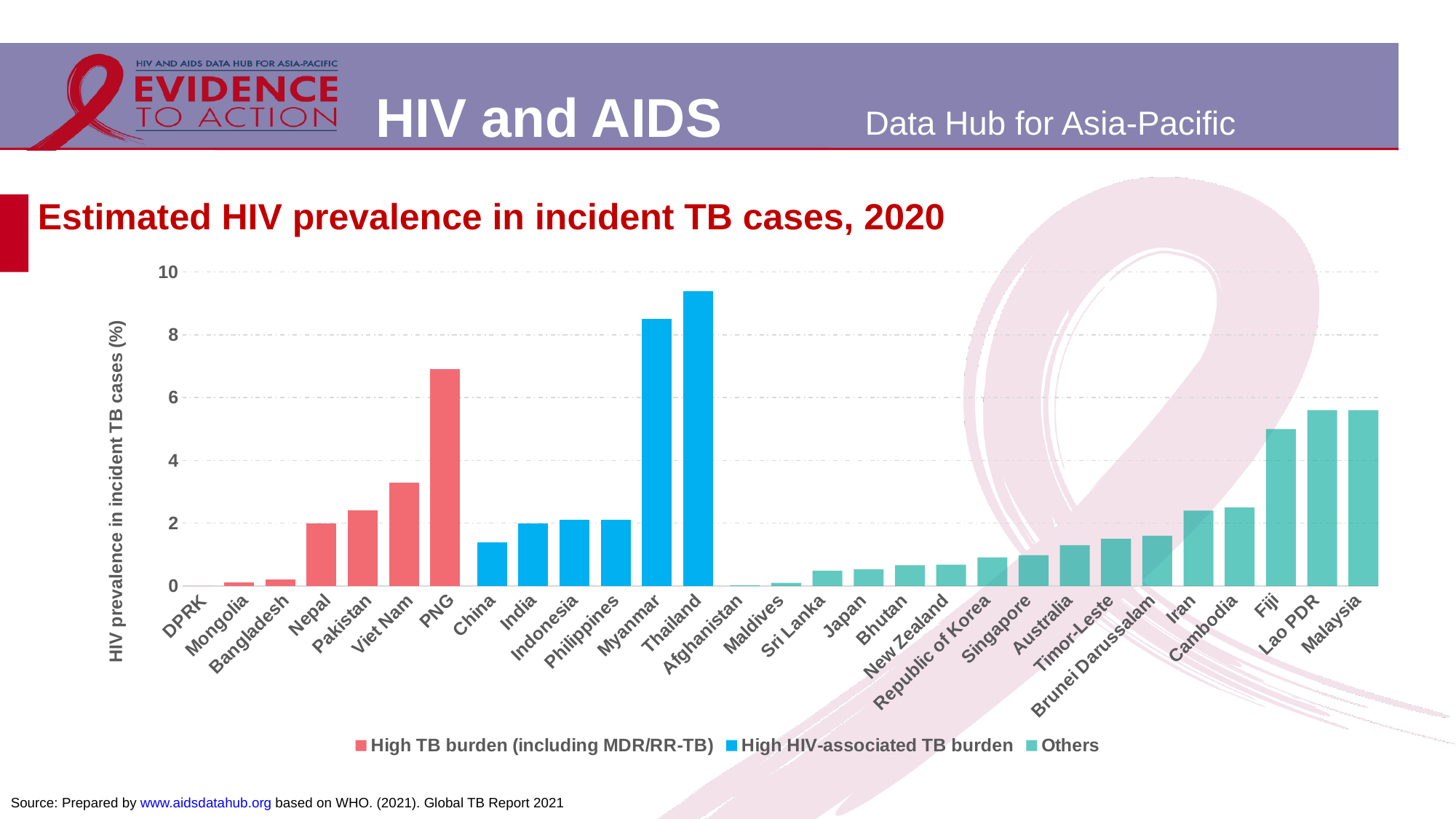
What type of chart is shown on the slide? Bar chart Is the value for Viet Nam greater or less than 4? less Is the value for Fiji greater or less than 4? greater How many countries are shown on the x axis of the chart? 29 Is the value for PNG greater or less than 6? greater Which country has the highest estimated HIV prevalence in incident TB cases? Thailand Which has a higher value, Fiji or Cambodia? Fiji How many series does the legend list? 3 What is the title of the chart? Estimated HIV prevalence in incident TB cases, 2020 Which has a higher value, Thailand or PNG? Thailand